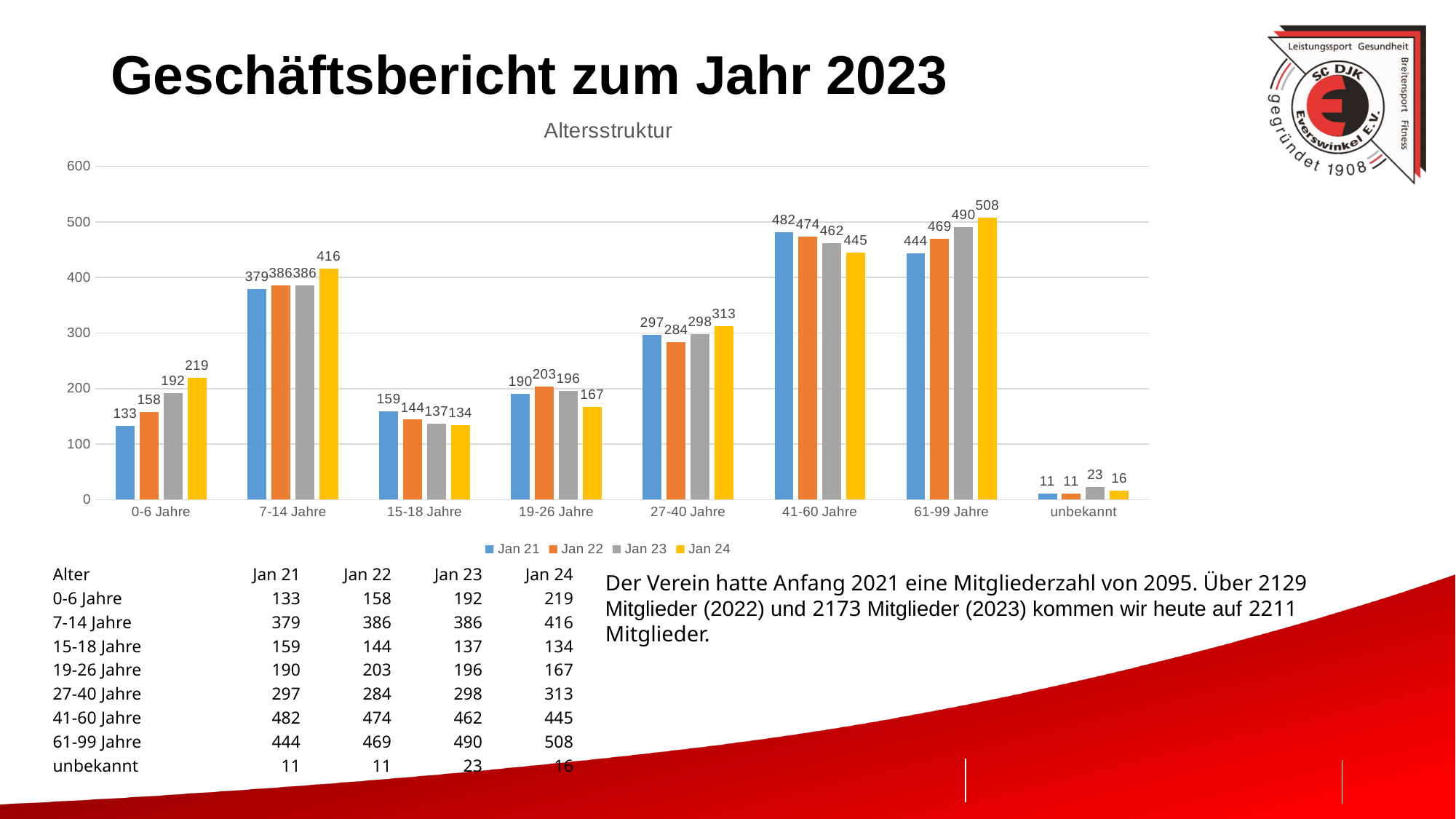
How many series does the legend list? 4 What is the value for Jan 23 in the 19-26 Jahre category? 196 Which is larger for 41-60 Jahre: the Jan 21 value or the Jan 24 value? Jan 21 Which age category has the lowest Jan 24 value? unbekannt What kind of chart is shown on the slide? bar chart What is the title of the chart? Altersstruktur What is the difference between the Jan 24 and Jan 21 values for 0-6 Jahre? 86 How many age categories are shown on the x axis? 8 Do the values for 15-18 Jahre rise or fall from Jan 21 to Jan 24? fall What is the value for Jan 21 in the 0-6 Jahre category? 133 Which age category has the highest Jan 21 value? 41-60 Jahre What is the value for Jan 24 in the 61-99 Jahre category? 508